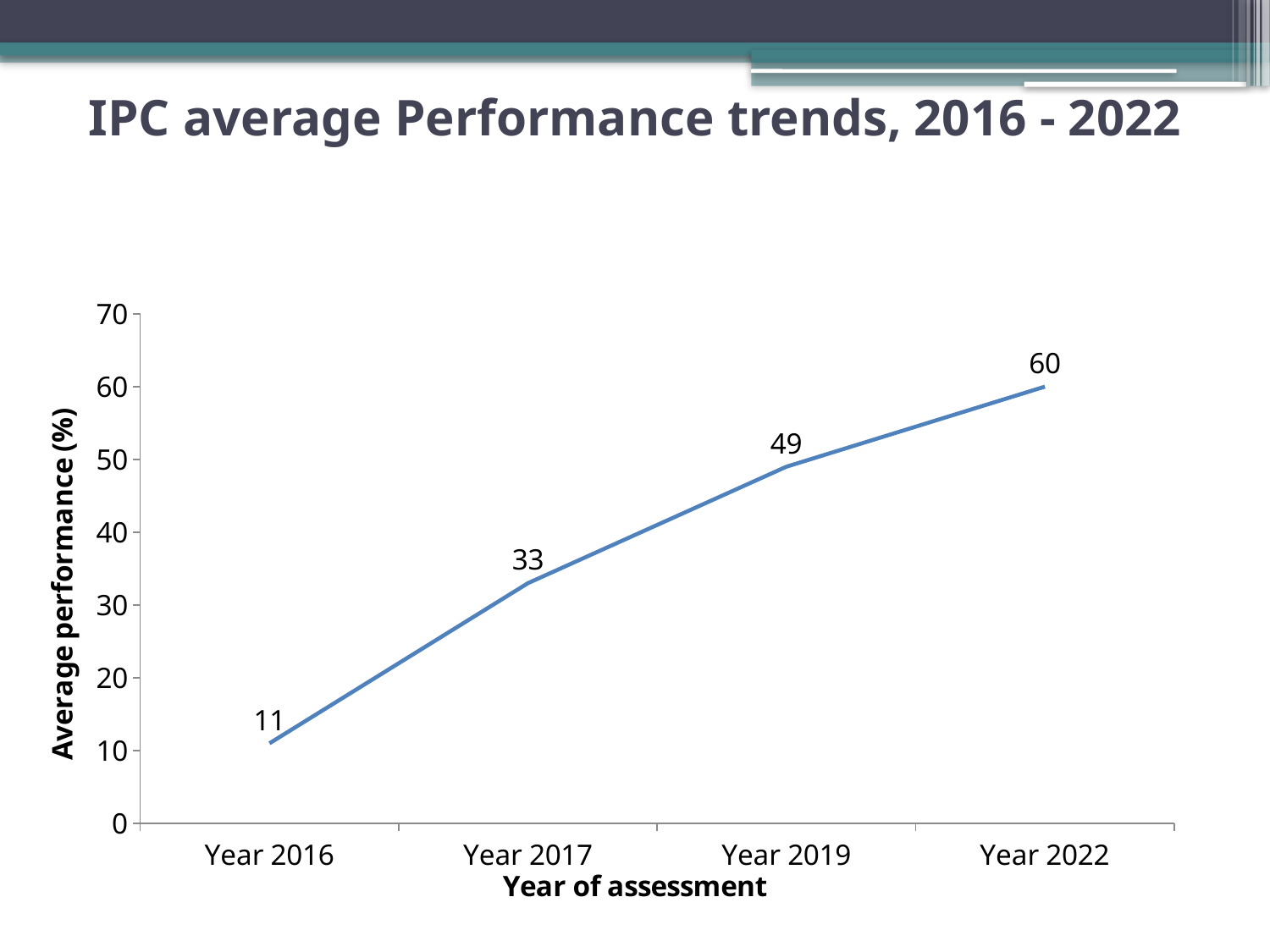
Which has a higher average performance, Year 2017 or Year 2019? Year 2019 What is the average performance for Year 2019? 49 What is the difference in average performance between Year 2019 and Year 2017? 16 What kind of chart is shown on the slide? Line chart What is the average performance for Year 2016? 11 Which year has the highest average performance? Year 2022 Does the average performance rise or fall from Year 2016 to Year 2022? Rise What is the average performance for Year 2017? 33 Which year has the lowest average performance? Year 2016 How many years of assessment are plotted on the chart? 4 What is the difference in average performance between Year 2022 and Year 2016? 49 What is the average performance for Year 2022? 60